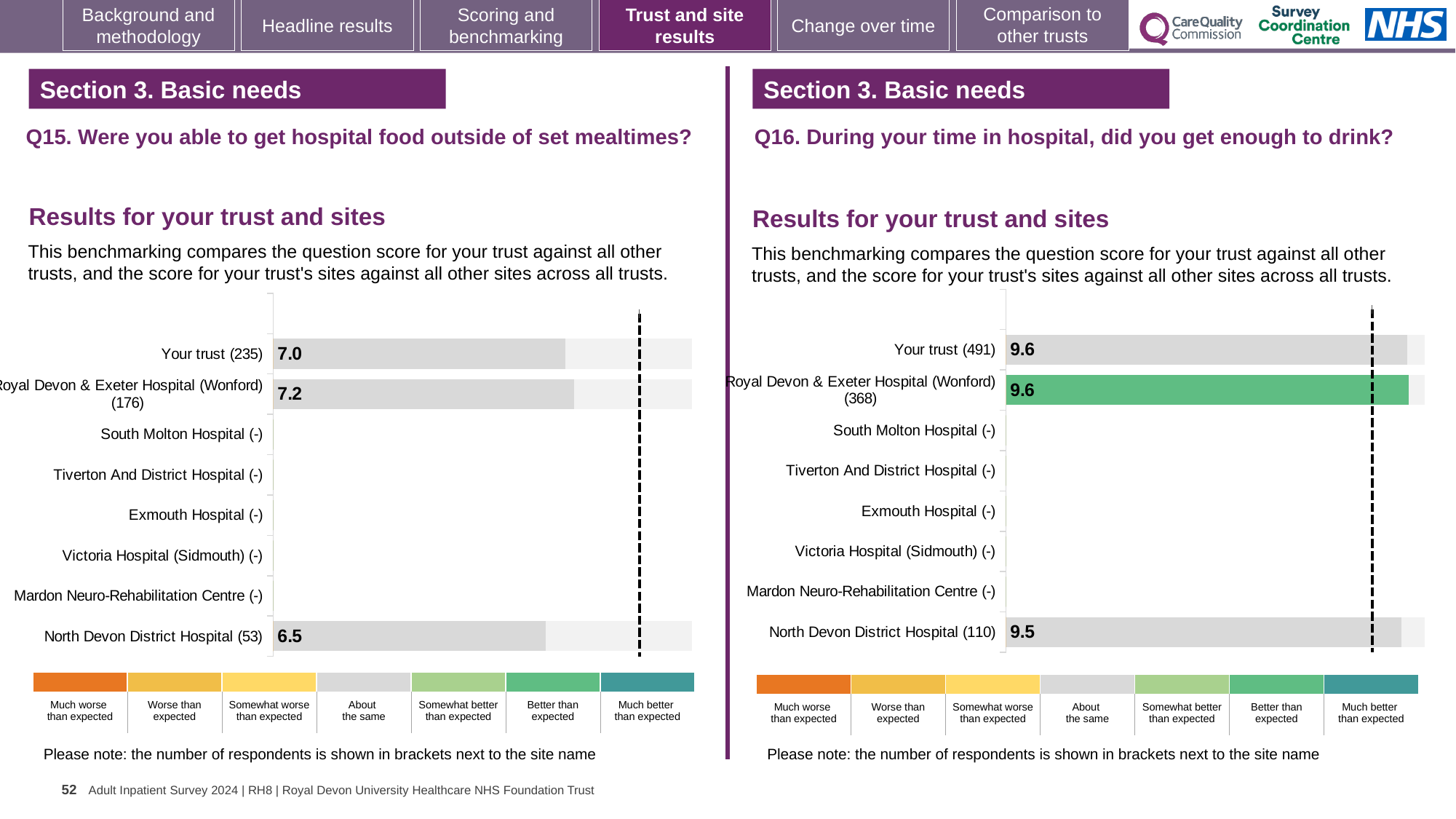
On the Q16 chart (right), which is larger: the score for Royal Devon & Exeter Hospital (Wonford) or the score for North Devon District Hospital? Royal Devon & Exeter Hospital (Wonford) On the Q16 chart (right), what is the score for North Devon District Hospital (110)? 9.5 On the Q15 chart (left), what is the score for Your trust (235)? 7.0 On the Q16 chart (right), what is the difference between the Your trust score and the North Devon District Hospital score? 0.1 On the Q15 chart (left), what is the score for North Devon District Hospital (53)? 6.5 What kind of chart is used on the Q16 chart (right)? Bar chart On the Q15 chart (left), what is the score for Royal Devon & Exeter Hospital (Wonford) (176)? 7.2 How many site or trust rows are listed on the Q15 chart (left)? 8 On the Q16 chart (right), what is the score for Your trust (491)? 9.6 On the Q15 chart (left), which site or trust row has the highest score? Royal Devon & Exeter Hospital (Wonford) (176) On the Q15 chart (left), which site or trust row has the lowest score? North Devon District Hospital (53) On the Q15 chart (left), what is the difference between the Royal Devon & Exeter Hospital (Wonford) score and the North Devon District Hospital score? 0.7